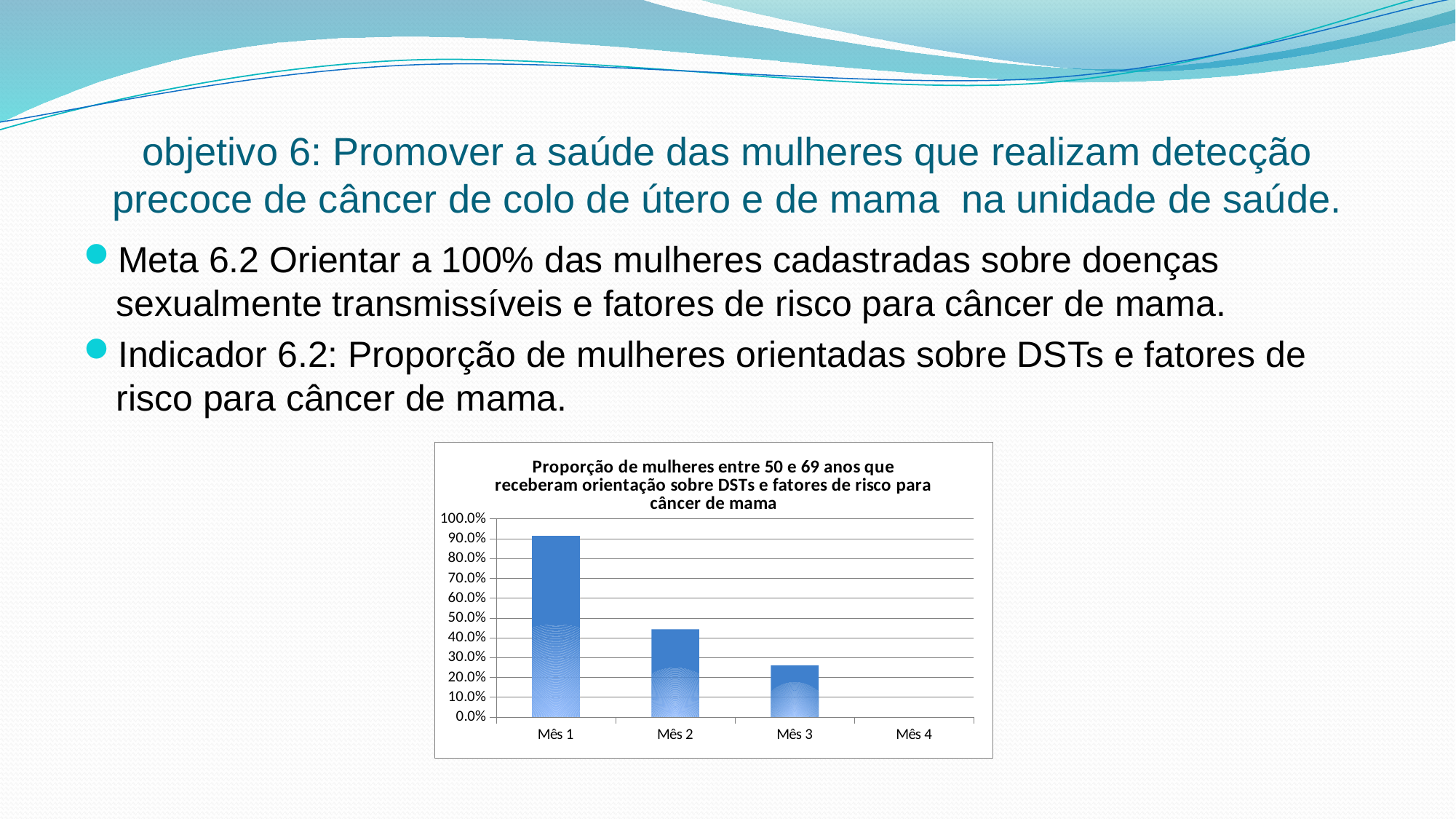
Is the value for Mês 3 greater or less than 20.0%? greater Is the value for Mês 3 greater or less than 30.0%? less Which month shows no visible bar in the chart? Mês 4 How many months (categories) are shown on the x axis of the chart? 4 Is the value for Mês 2 greater or less than 50.0%? less Do the values rise or fall from Mês 1 to Mês 4? fall What kind of chart is shown on the slide? bar chart Which is larger, the value for Mês 2 or the value for Mês 3? Mês 2 Which month has the highest value in the chart? Mês 1 What is the maximum value shown on the y axis of the chart? 100.0%